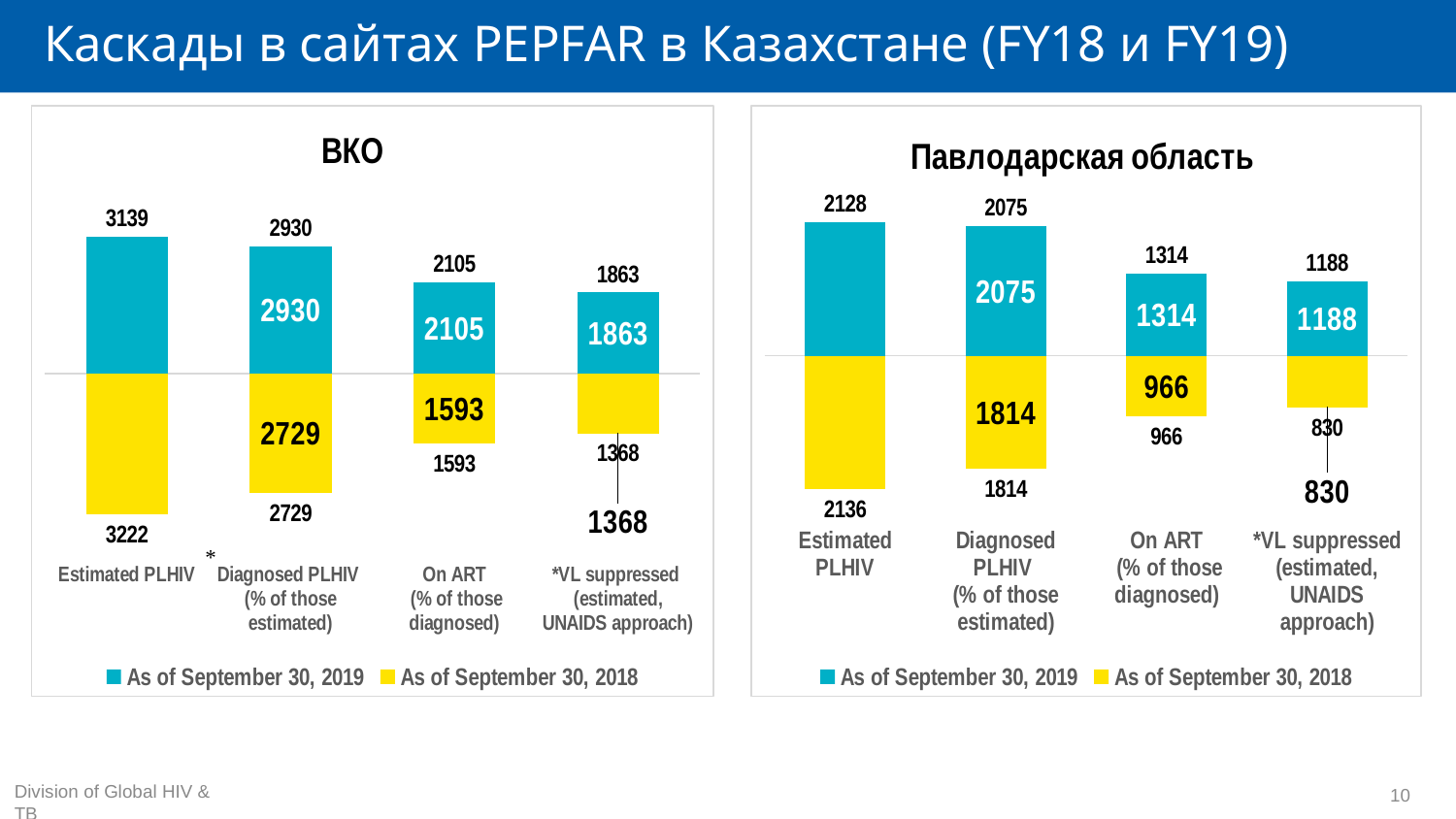
In the ВКО chart, which is larger for Estimated PLHIV: the 2019 value or the 2018 value? 2018 value In the ВКО chart, what is the difference between the 2019 and 2018 values for *VL suppressed? 495 In the ВКО chart, what is the value for On ART as of September 30, 2018? 1593 In the Павлодарская область chart, which category has the highest value as of September 30, 2019? Estimated PLHIV In the ВКО chart, what is the value for Estimated PLHIV as of September 30, 2019? 3139 How many series does the legend of the ВКО chart list? 2 In the Павлодарская область chart, what is the value for Diagnosed PLHIV as of September 30, 2018? 1814 How many categories are shown in the Павлодарская область chart? 4 In the Павлодарская область chart, what is the difference between the 2019 and 2018 values for On ART? 348 In the ВКО chart, which category has the lowest value as of September 30, 2018? *VL suppressed In the ВКО chart, do the 2019 values rise or fall from Estimated PLHIV to *VL suppressed? fall In the Павлодарская область chart, what is the value for *VL suppressed as of September 30, 2019? 1188